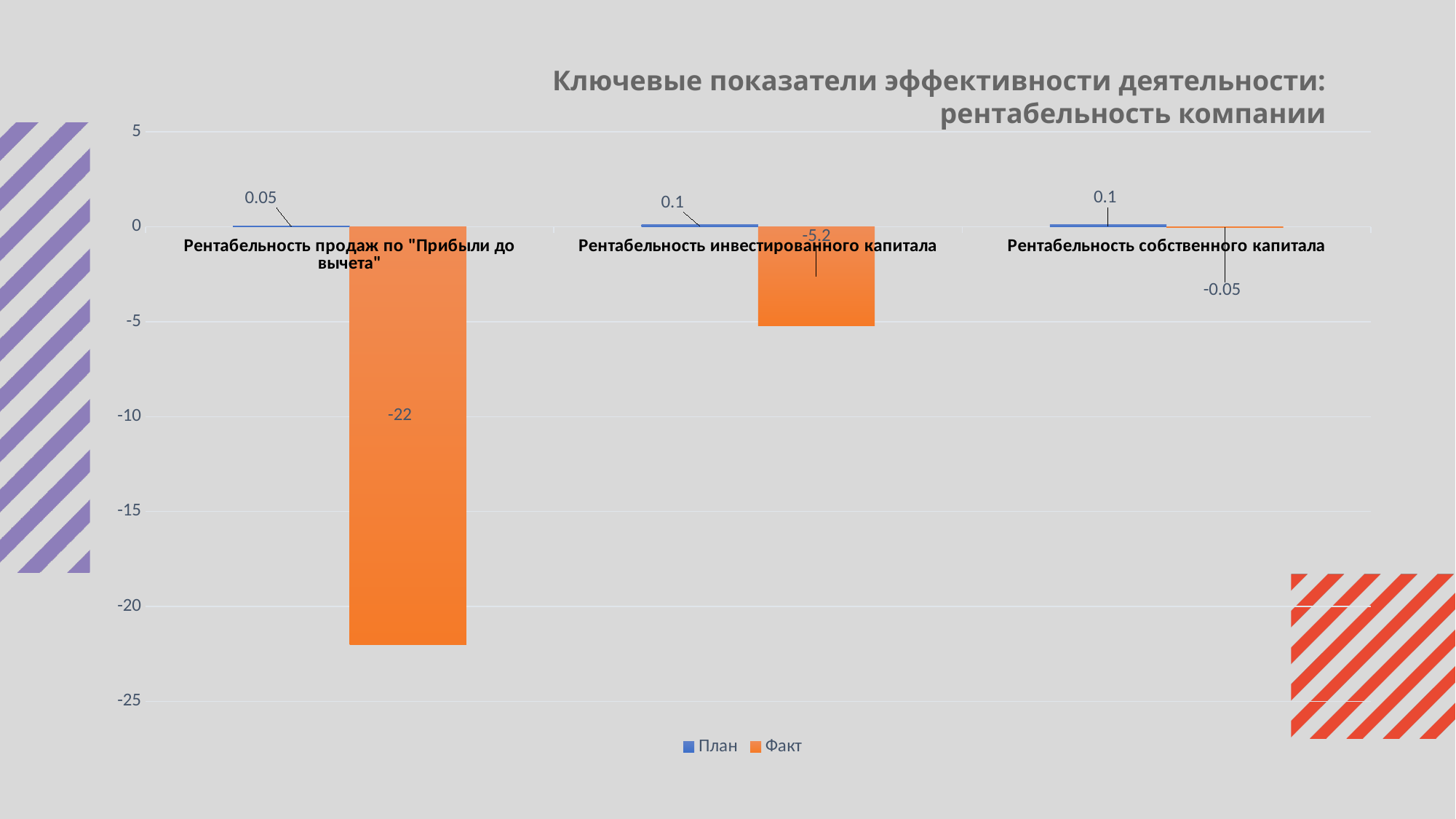
What type of chart is shown on the slide? Bar chart What is the План value for Рентабельность инвестированного капитала? 0.1 Which category has the lowest Факт value? Рентабельность продаж по "Прибыли до вычета" What is the difference between the План and Факт values for Рентабельность инвестированного капитала? 5.3 What is the Факт value for Рентабельность собственного капитала? -0.05 What is the Факт value for Рентабельность продаж по "Прибыли до вычета"? -22 Which category has the highest Факт value? Рентабельность собственного капитала What is the Факт value for Рентабельность инвестированного капитала? -5.2 Which is larger: the Факт value for Рентабельность инвестированного капитала or the Факт value for Рентабельность продаж по "Прибыли до вычета"? Рентабельность инвестированного капитала What is the План value for Рентабельность продаж по "Прибыли до вычета"? 0.05 How many series does the legend list? 2 How many categories are shown on the x axis? 3